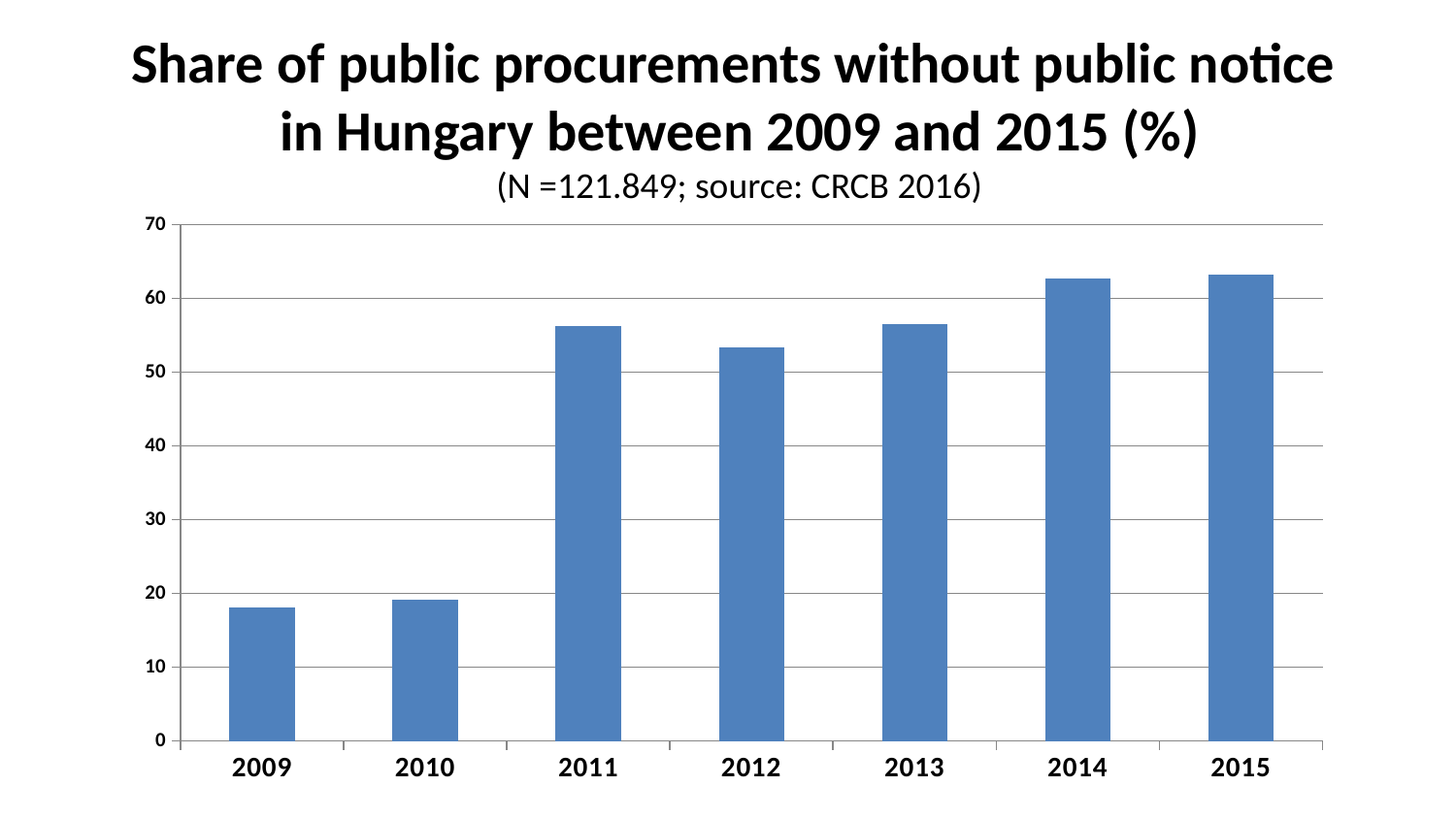
Is the value for 2009 greater or less than 20? less Which year has the larger value, 2011 or 2012? 2011 Is the value for 2013 greater or less than 60? less Is the value for 2014 greater or less than 60? greater Do the values generally rise or fall from 2009 to 2015? rise Which year has the larger value, 2013 or 2014? 2014 How many years are shown on the x axis of the chart? 7 Which year has the larger value, 2010 or 2011? 2011 What is the sample size (N) stated in the chart subtitle? 121.849 What kind of chart is shown on the slide? bar chart